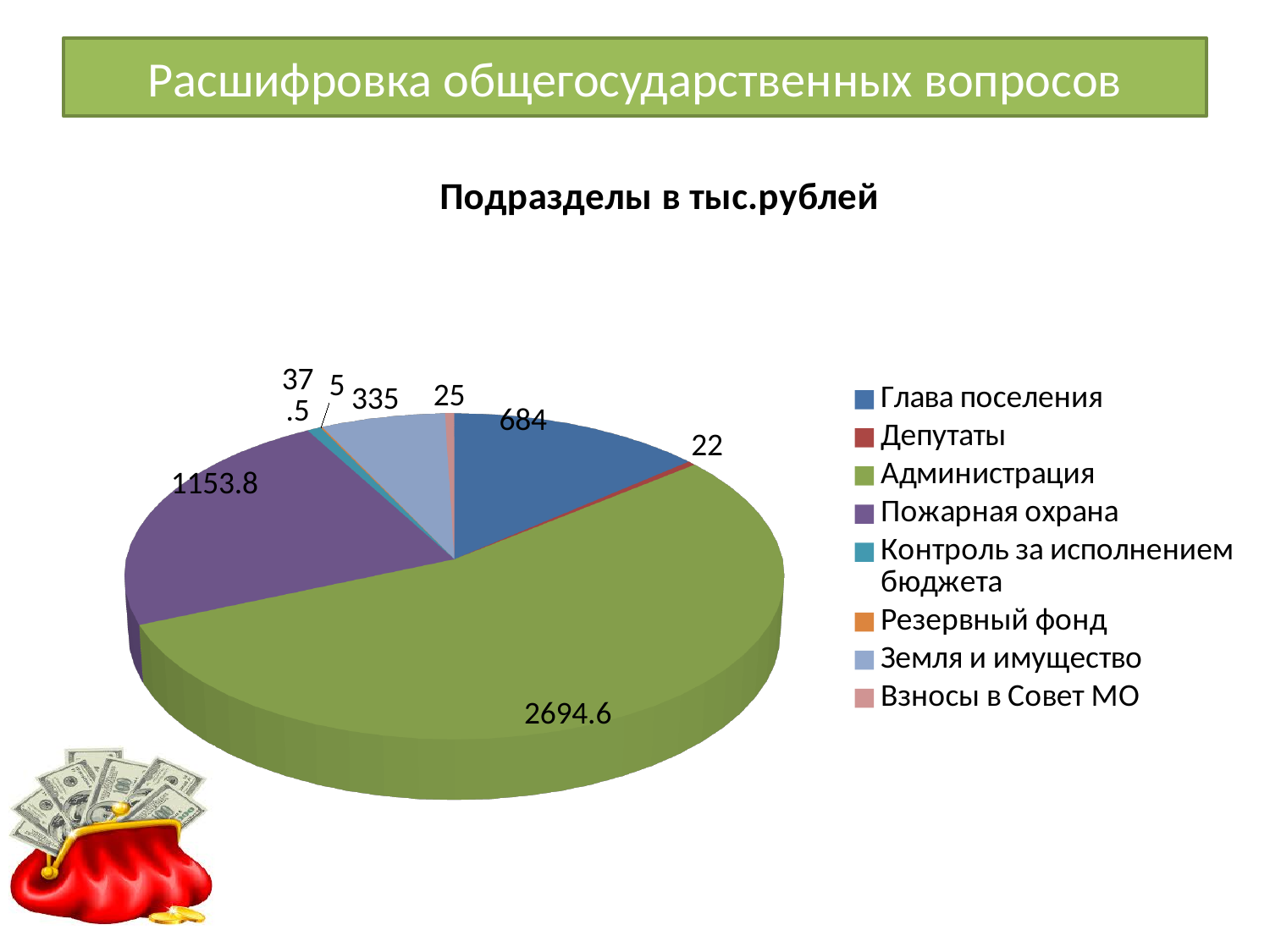
Which is larger, the value for Глава поселения or the value for Земля и имущество? Глава поселения Which category has the largest slice of the pie? Администрация What is the value for Земля и имущество? 335 What is the value for Контроль за исполнением бюджета? 37.5 What is the title of the chart? Подразделы в тыс.рублей What is the value for Администрация? 2694.6 What is the value for Глава поселения? 684 What is the value for Пожарная охрана? 1153.8 What is the difference between the values for Администрация and Пожарная охрана? 1540.8 Which category has the smallest value? Резервный фонд How many categories does the legend list? 8 What type of chart is shown on the slide? pie chart